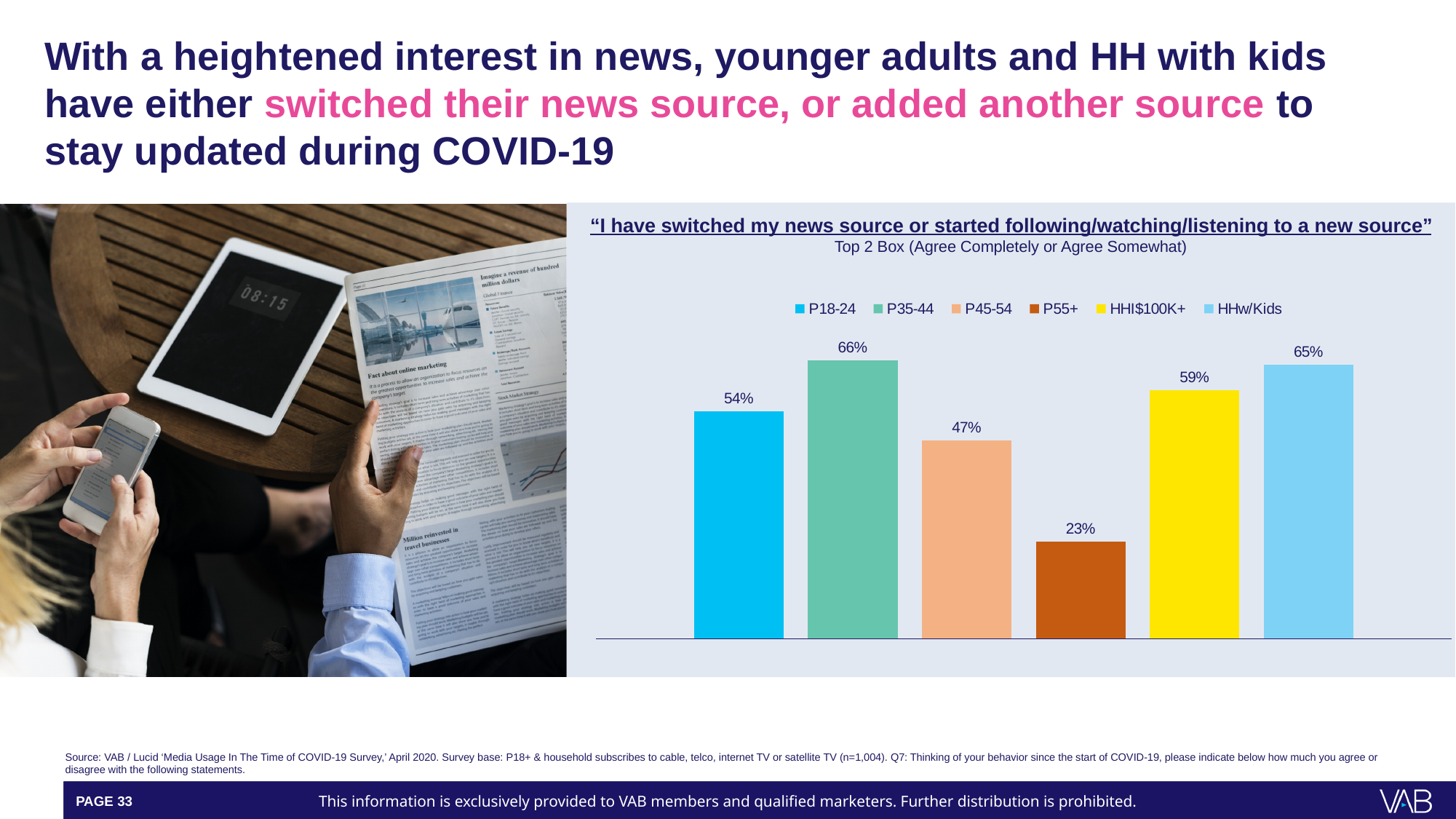
Which group has the lowest value? P55+ How many bars are shown in the chart? 6 What is the value for P18-24? 54% What is the difference between the values for HHw/Kids and P55+? 42% Which is larger, the value for HHI$100K+ or the value for P18-24? HHI$100K+ Which group has the highest value? P35-44 What is the value for P55+? 23% What is the difference between the values for P35-44 and P45-54? 19% What is the subtitle shown below the chart title? Top 2 Box (Agree Completely or Agree Somewhat) What kind of chart is shown on the slide? Bar chart What is the value for HHw/Kids? 65% How many entries does the legend list? 6